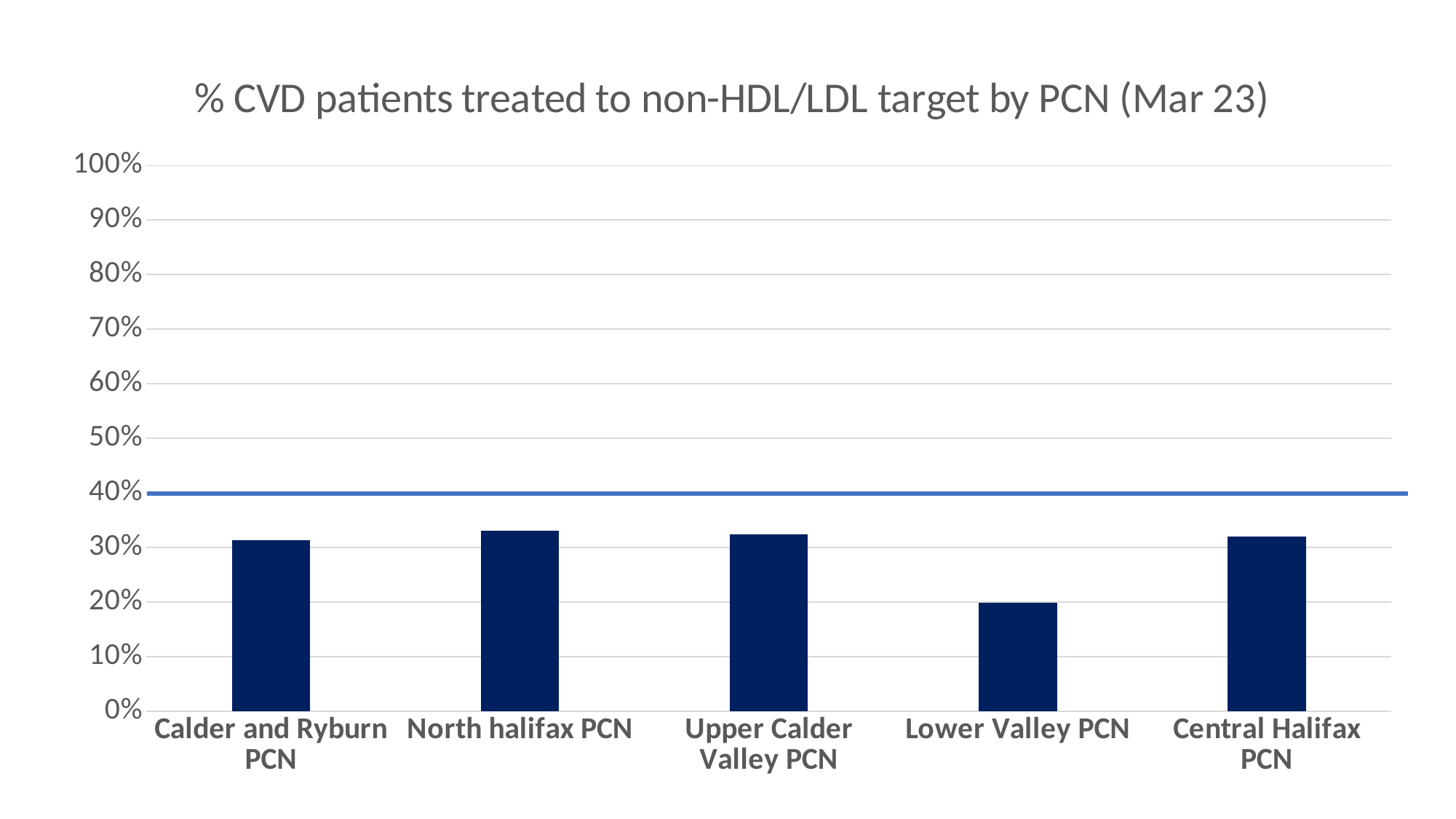
Which is larger, the value for Calder and Ryburn PCN or the value for Lower Valley PCN? Calder and Ryburn PCN Is the value for North halifax PCN greater or less than 30%? greater Which PCN has the lowest percentage of CVD patients treated to non-HDL/LDL target? Lower Valley PCN At what percentage level is the horizontal reference line drawn across the chart? 40% Which is larger, the value for North halifax PCN or the value for Lower Valley PCN? North halifax PCN What is the title of the chart? % CVD patients treated to non-HDL/LDL target by PCN (Mar 23) Is the value for Upper Calder Valley PCN greater or less than 20%? greater Is the value for Lower Valley PCN greater or less than 30%? less How many PCNs are shown on the x axis of the chart? 5 What kind of chart is shown on the slide? Bar chart